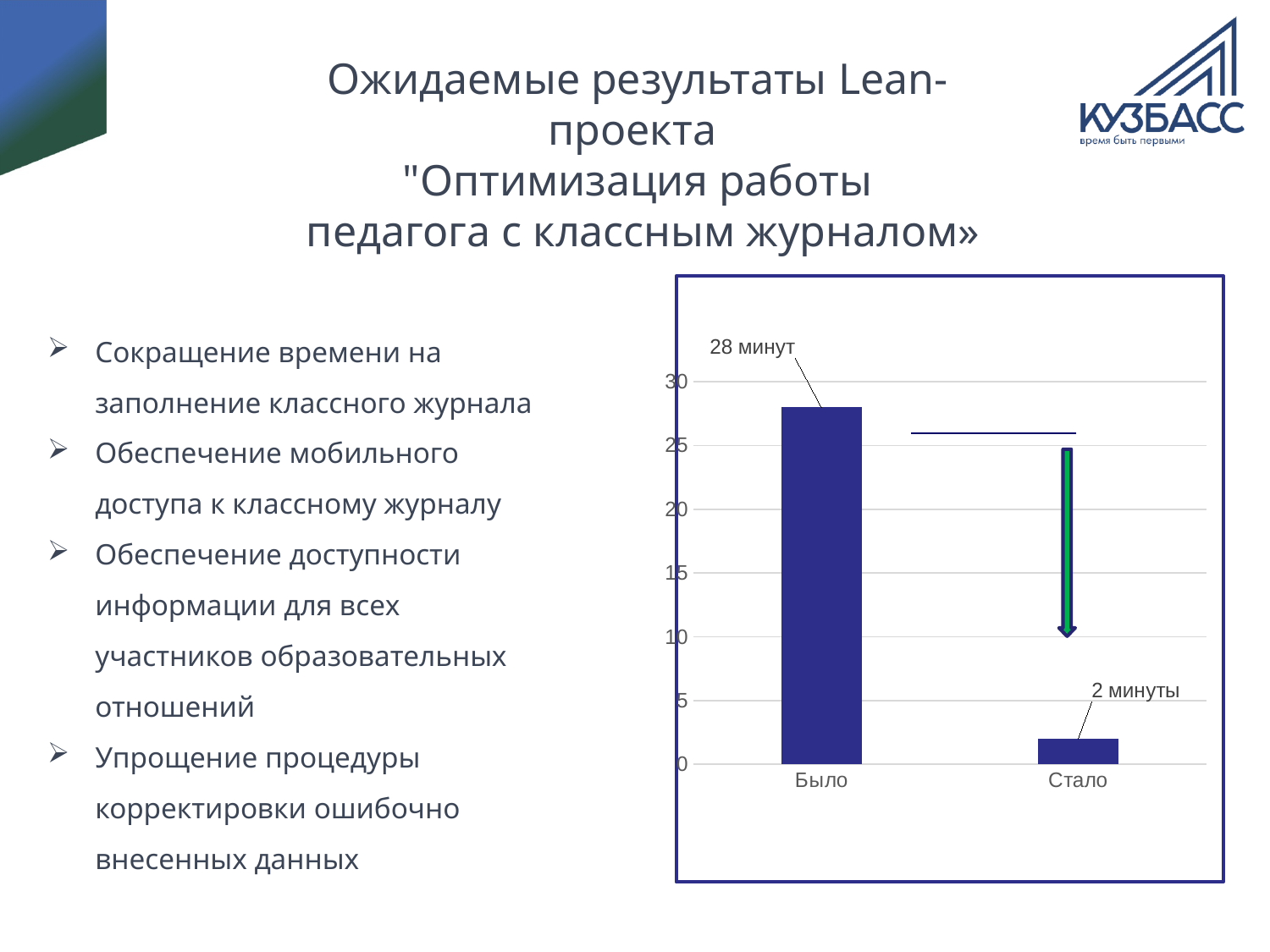
What is the highest tick value shown on the vertical axis of the chart? 30 What is the difference in minutes between the "Было" and "Стало" values? 26 Is the value for "Было" greater or less than 25? greater Is the value for "Стало" greater or less than 5? less Do the values rise or fall from "Было" to "Стало" along the x axis? fall Which category has the highest value on the chart? Было What is the value for "Стало" on the chart? 2 минуты How many categories are shown on the x axis of the chart? 2 Which is larger, the value for "Было" or the value for "Стало"? Было What kind of chart is shown on the slide? bar chart What is the value for "Было" on the chart? 28 минут Which category has the lowest value on the chart? Стало